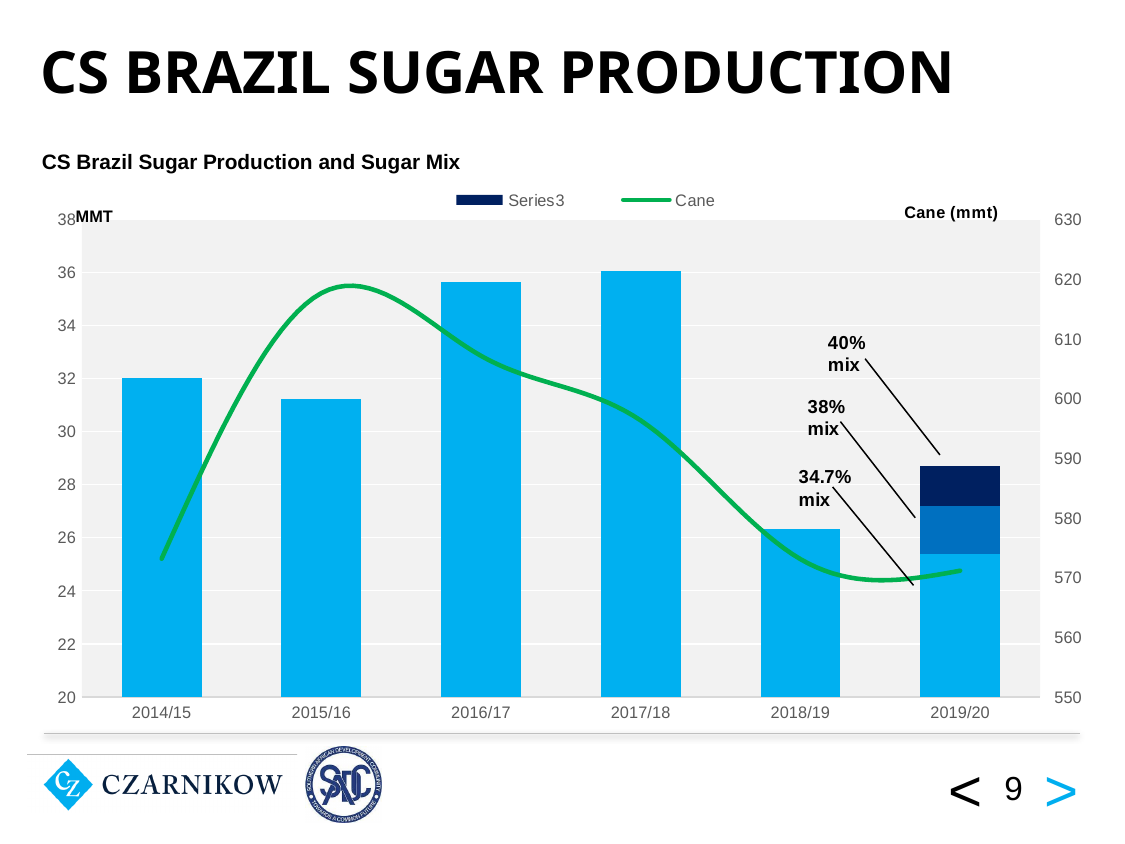
Which is larger, the sugar production bar for 2014/15 or for 2015/16? 2014/15 In which season does the Cane line reach its highest point? 2015/16 Is the Cane value for 2015/16 greater or less than 610 on the right axis? greater Which season has the tallest sugar production bar? 2017/18 Is the sugar production bar for 2018/19 greater or less than 28 MMT? less Does the Cane line rise or fall from 2015/16 to 2019/20? fall What kind of chart is shown on the slide? Combined bar and line chart What mix percentage is labelled for the top (darkest) segment of the 2019/20 bar? 40% mix Is the sugar production bar for 2017/18 greater or less than 34 MMT? greater How many seasons are shown on the x axis? 6 How many series does the legend list? 2 What is the label of the right-hand axis? Cane (mmt)